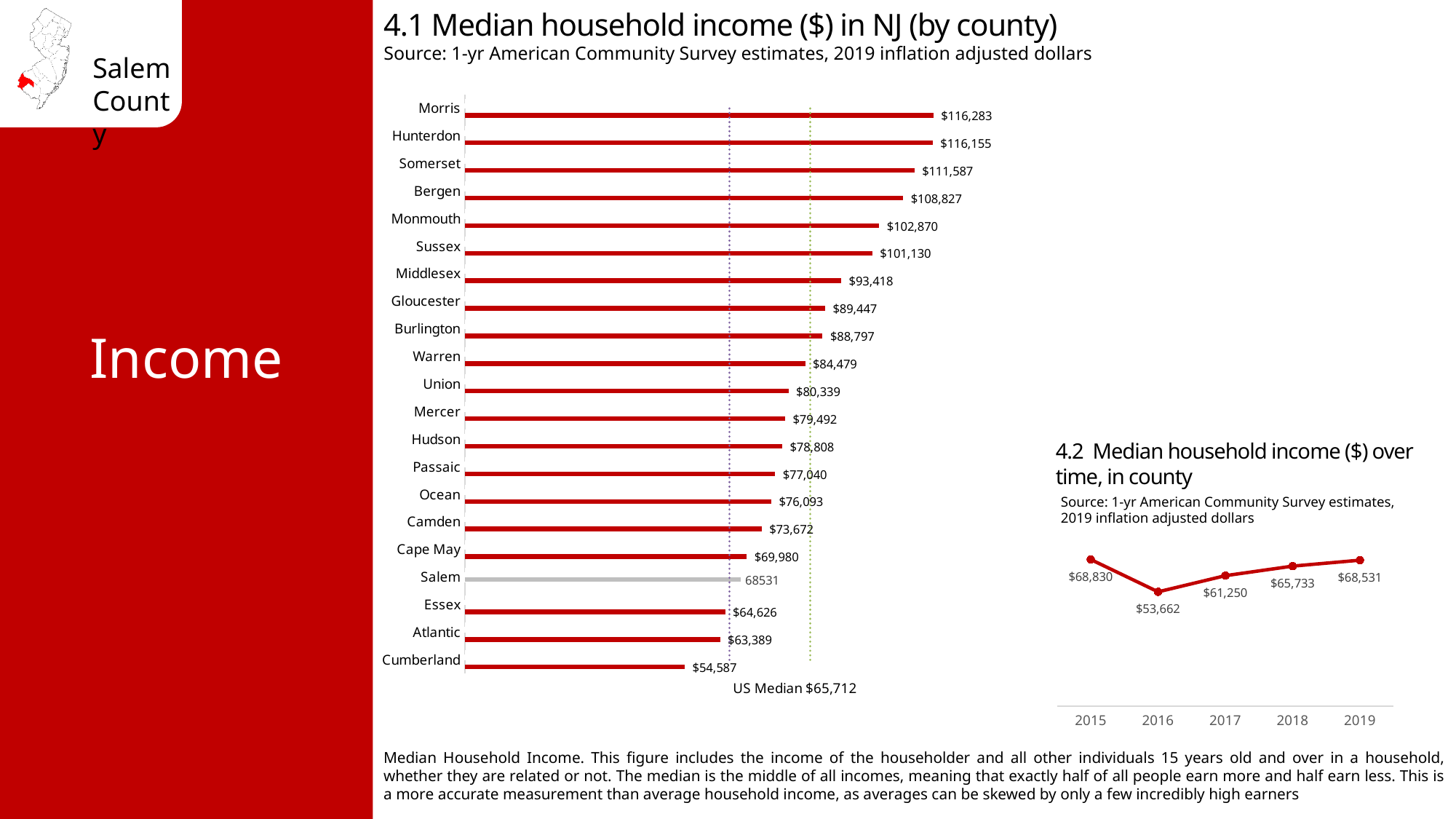
In chart 4.1 (Median household income in NJ by county), which county has the highest median household income? Morris In chart 4.1 (Median household income in NJ by county), which county has the lowest median household income? Cumberland In chart 4.1 (Median household income in NJ by county), what US Median value is labelled on the chart? $65,712 In chart 4.2 (Median household income over time, in county), how much did the median household income increase from 2016 to 2019? $14,869 What kind of chart is chart 4.1 (Median household income in NJ by county)? Bar chart In chart 4.1 (Median household income in NJ by county), which has a higher median household income, Monmouth or Sussex? Monmouth In chart 4.1 (Median household income in NJ by county), what is the value shown for Salem? 68531 In chart 4.1 (Median household income in NJ by county), how many counties are shown? 21 In chart 4.1 (Median household income in NJ by county), what is the median household income for Gloucester? $89,447 In chart 4.2 (Median household income over time, in county), what was the median household income in 2016? $53,662 In chart 4.1 (Median household income in NJ by county), what is the difference between Atlantic's and Cumberland's median household income? $8,802 In chart 4.2 (Median household income over time, in county), which year has the lowest median household income? 2016